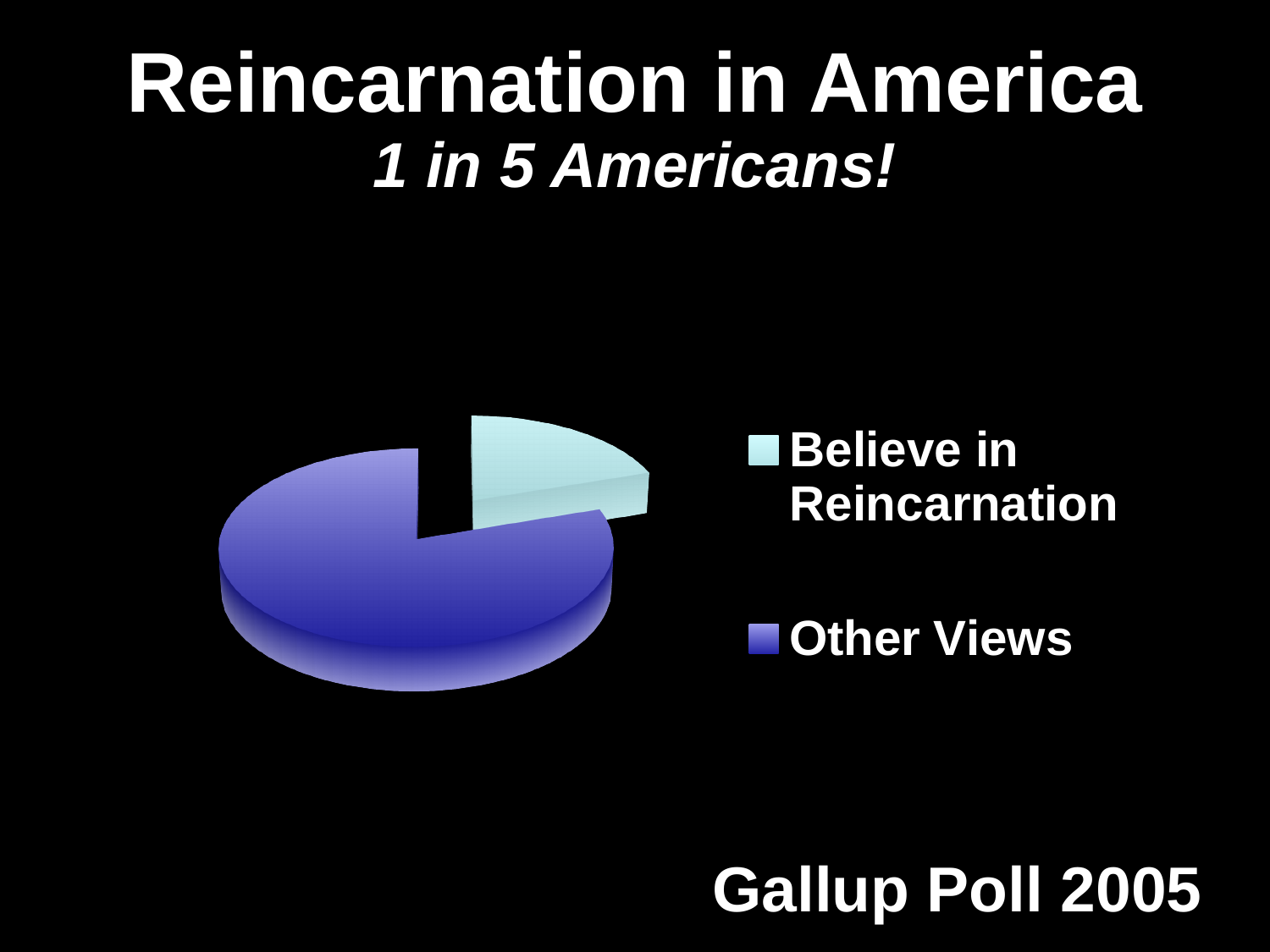
Which slice of the pie chart is the largest? Other Views Is the share of the pie for Believe in Reincarnation greater or less than half? less How many entries does the legend list? 2 Which legend entry is shown in light cyan? Believe in Reincarnation Which is larger: the slice for Believe in Reincarnation or the slice for Other Views? Other Views How many slices does the pie chart have? 2 Which slice of the pie chart is the smallest? Believe in Reincarnation What kind of chart is shown on the slide? pie chart What is the title of the slide containing the pie chart? Reincarnation in America